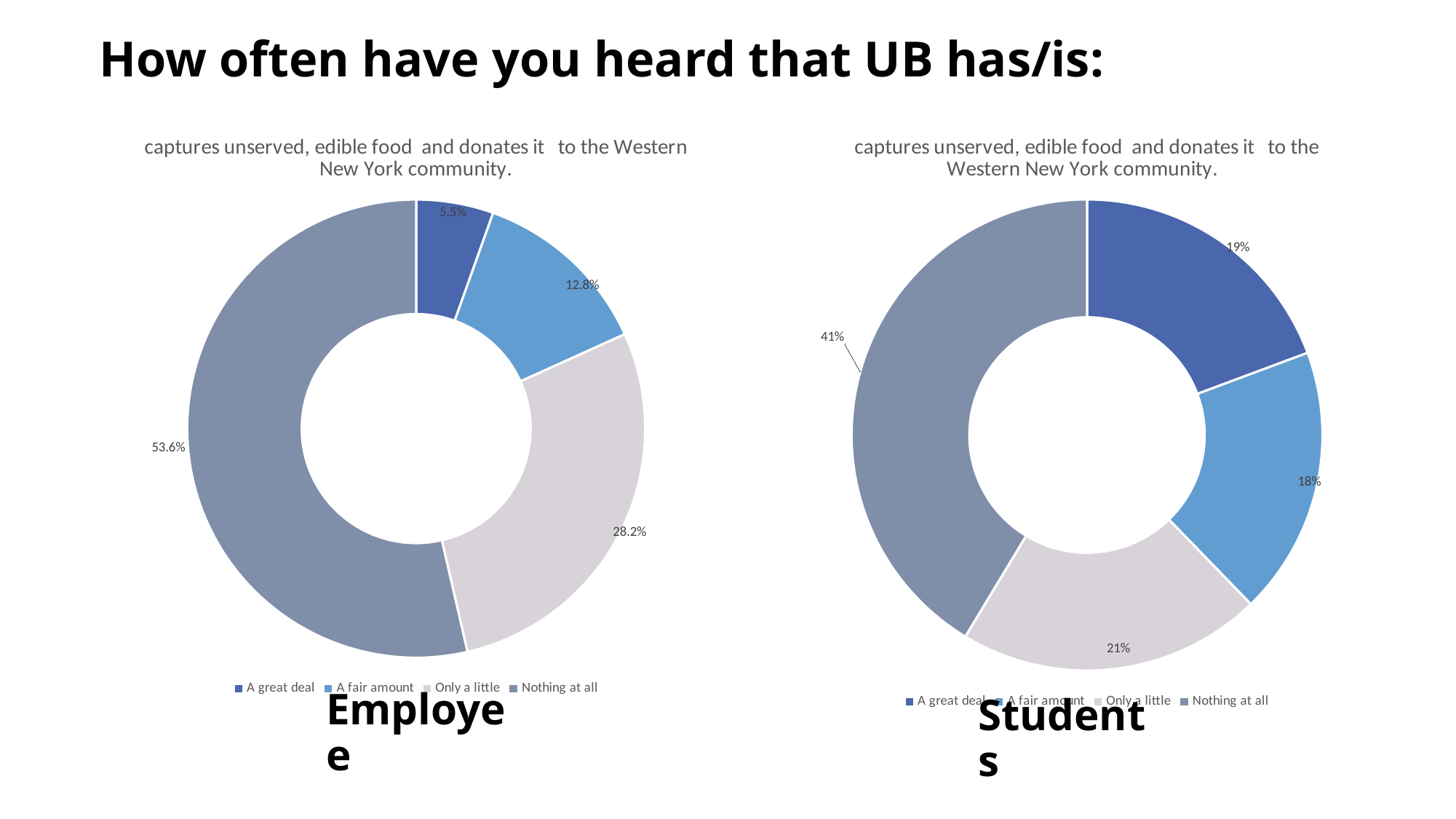
On the Students chart, what is the difference between 'Nothing at all' and 'A fair amount'? 23% On the Students chart, what percentage is shown for 'Nothing at all'? 41% Which is larger on the Students chart: 'A great deal' or 'Nothing at all'? Nothing at all On the Employees chart, what percentage is shown for 'A fair amount'? 12.8% On the Employees chart, which category has the smallest share? A great deal How many categories does the legend of the Employees chart list? 4 On the Employees chart, what is the difference between 'Only a little' and 'A great deal'? 22.7% What type of chart is used on the Employees (left) chart? Doughnut chart On the Students chart, which category has the largest share? Nothing at all On the Employees chart, what percentage is shown for 'Nothing at all'? 53.6% On the Students chart, what percentage is shown for 'Only a little'? 21% Which group has a higher 'A great deal' share: Employees or Students? Students